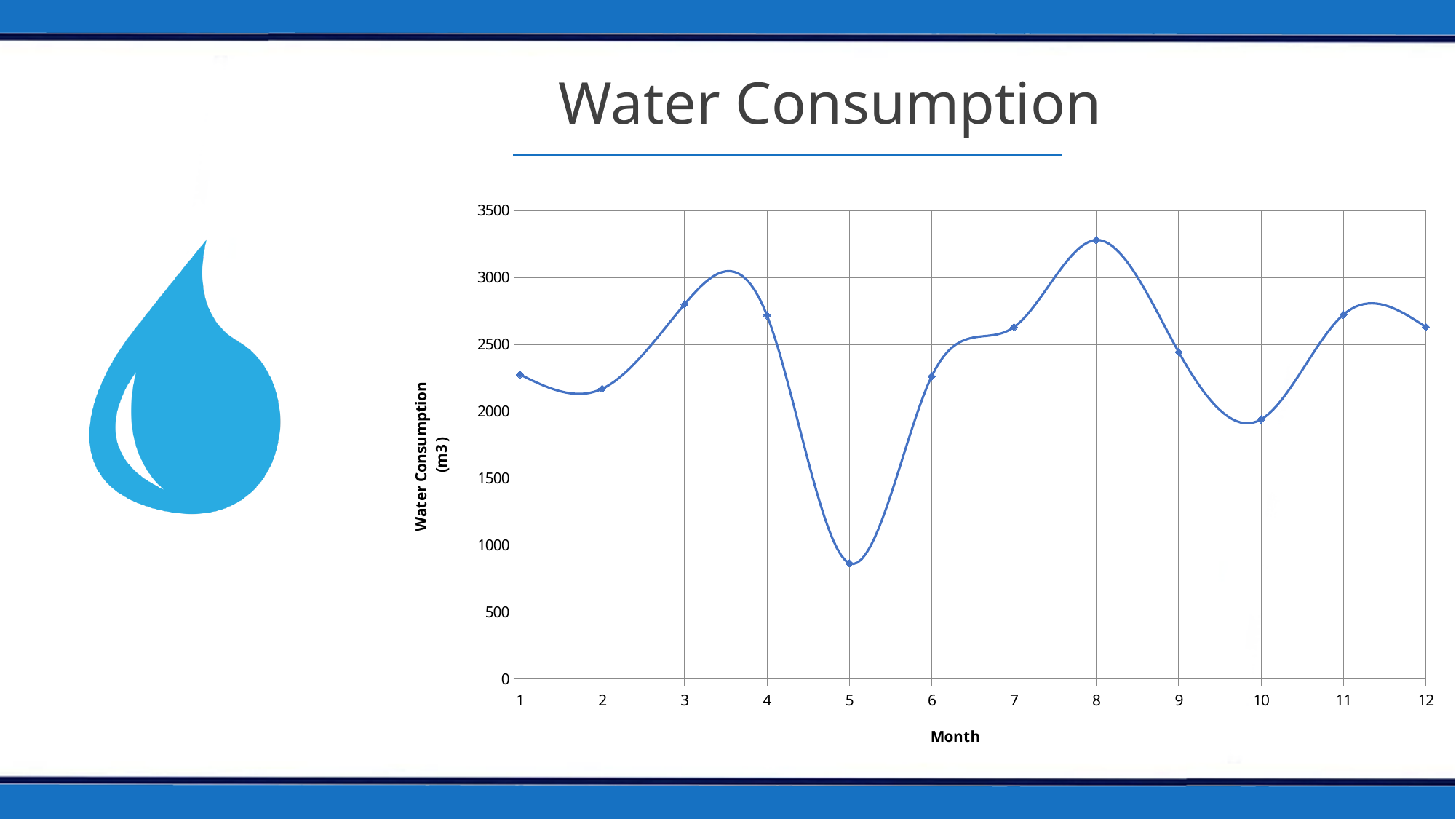
What kind of chart is shown on the slide? line chart Is the water consumption for month 5 greater or less than 1000? less Which month has the lowest water consumption? 5 What is the title of the slide? Water Consumption Is the water consumption for month 10 greater or less than 2000? less How many months are plotted on the x axis? 12 Is the water consumption for month 8 greater or less than 3000? greater Which has higher water consumption, month 3 or month 5? month 3 Does water consumption rise or fall from month 4 to month 5? fall Which month has the highest water consumption? 8 What is the label on the y axis? Water Consumption (m3)